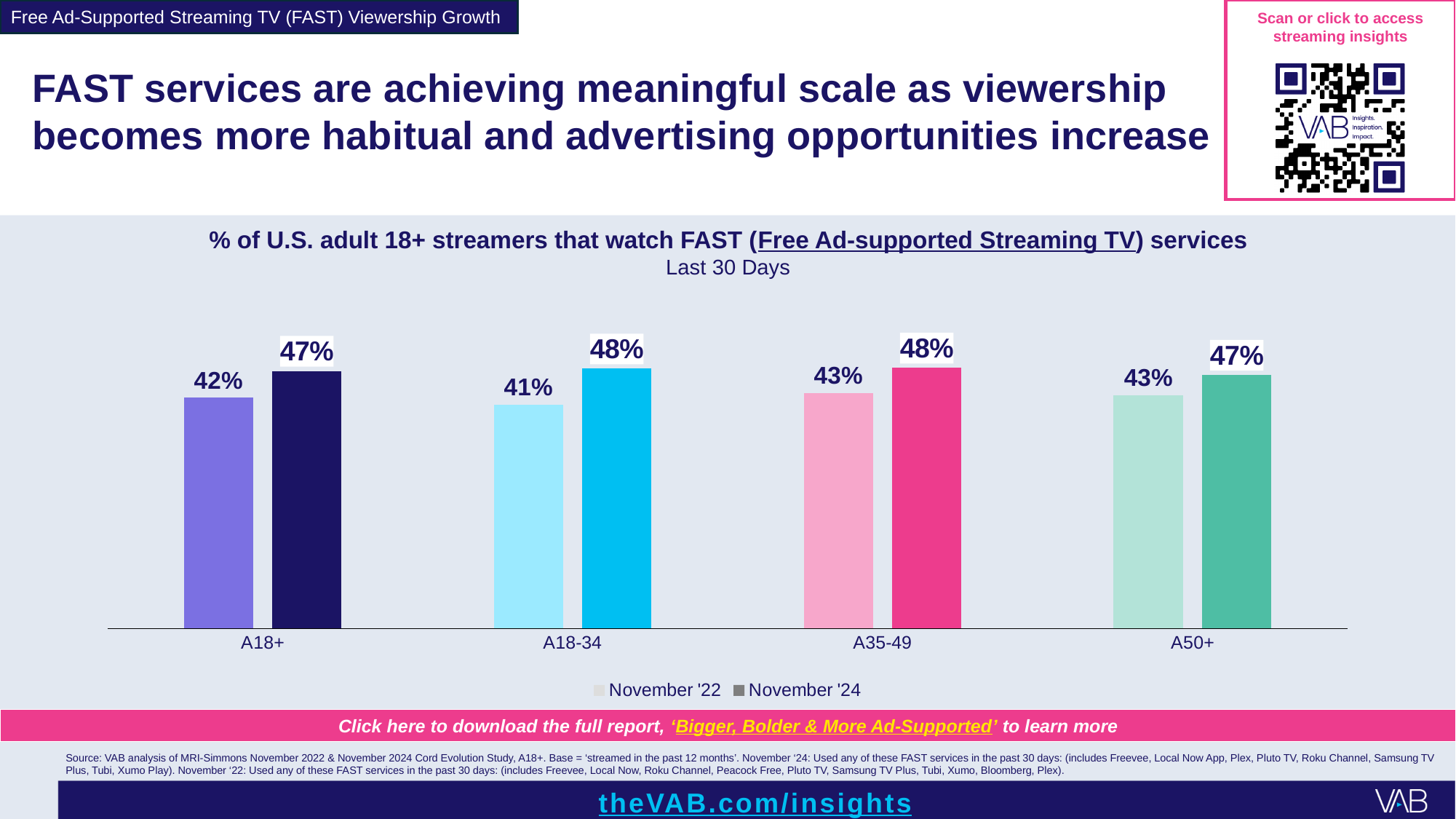
How many age groups are shown on the x axis? 4 What time period does the chart subtitle specify? Last 30 Days What is the November '24 value for A35-49? 48% How many series does the legend list? 2 What is the November '22 value for A50+? 43% Which age group has the lowest November '22 value? A18-34 What kind of chart is shown on the slide? Bar chart What is the difference between the November '24 and November '22 values for A18-34? 7 percentage points What is the November '24 value for A18-34? 48% Which is larger for A50+: the November '22 value or the November '24 value? November '24 What is the November '22 value for A18+? 42% What is the difference between the November '24 and November '22 values for A18+? 5 percentage points